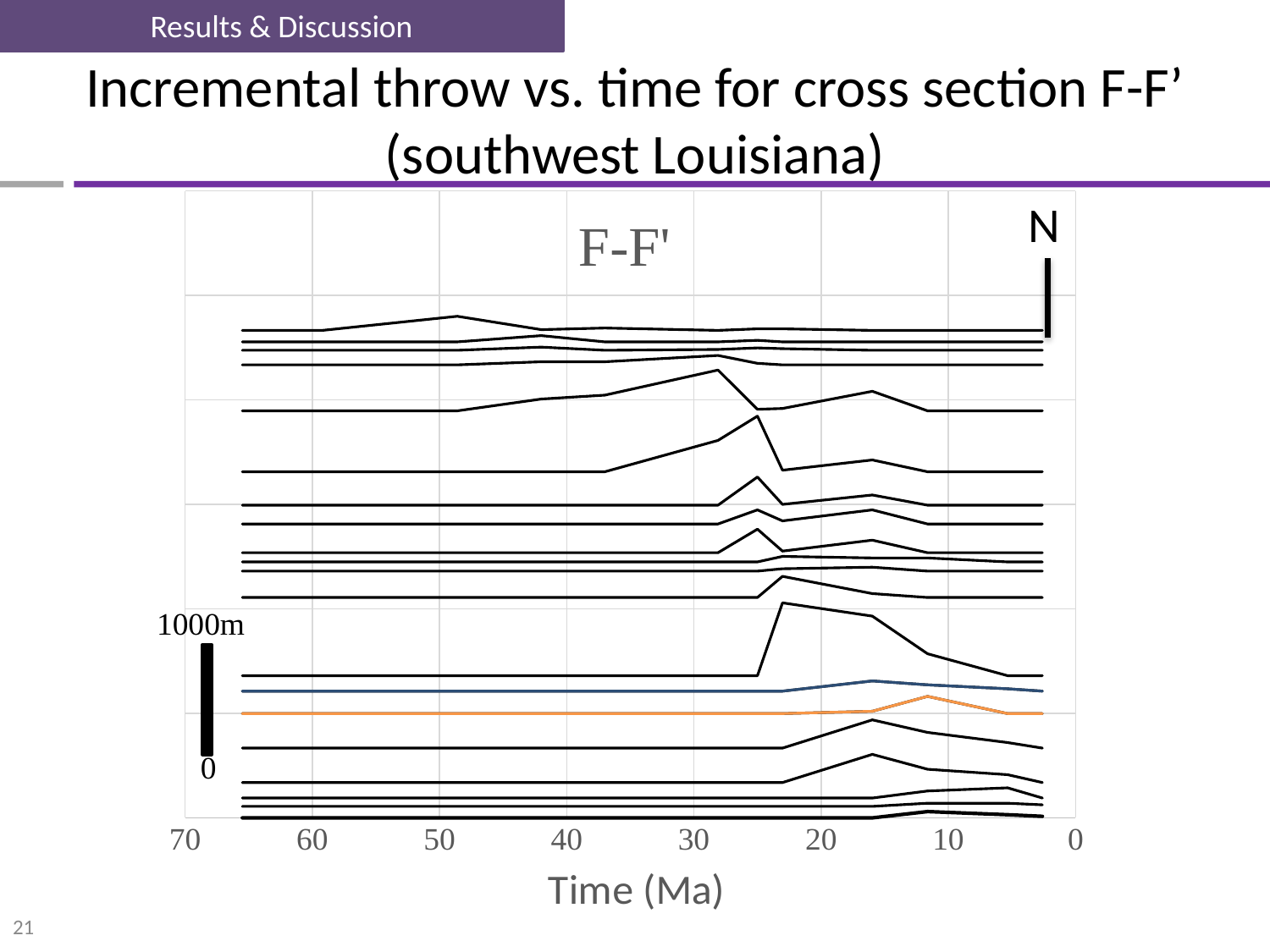
What kind of chart is shown on the slide? line chart What is the label of the x axis of the chart? Time (Ma) Do the x-axis tick values increase or decrease from left to right on the chart? decrease What is the rightmost tick value on the x axis of the chart? 0 How many tick labels are shown on the x axis of the chart? 8 What title is printed inside the chart area? F-F' What is the leftmost tick value on the x axis of the chart? 70